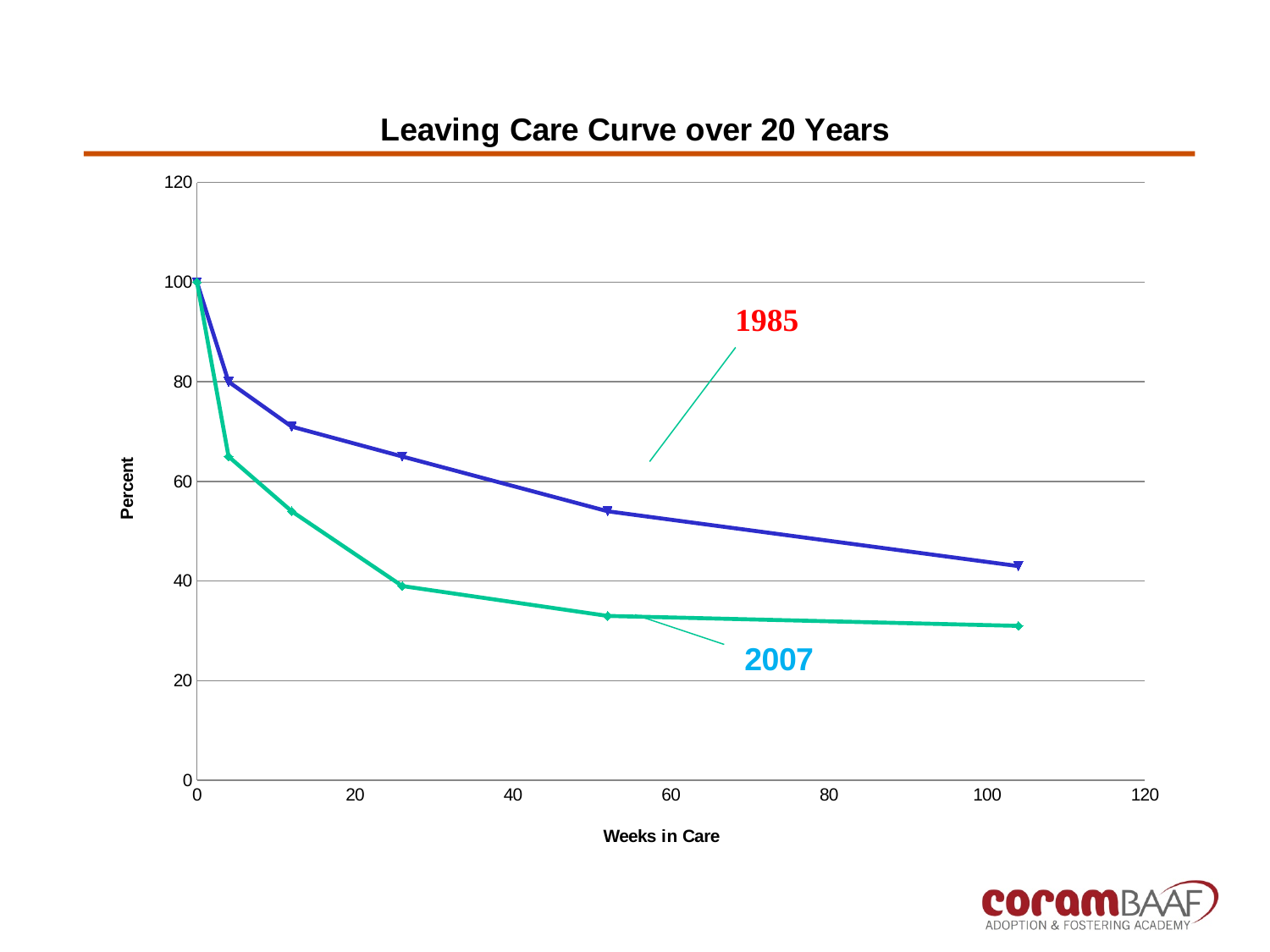
What is the label of the x axis? Weeks in Care At around 52 weeks in care, which series has the higher value, 1985 or 2007? 1985 How many data points are plotted for the 1985 series? 6 Do the values of the 2007 series rise or fall as weeks in care increase? fall Is the value for the 2007 series at around 52 weeks greater or less than 40? less What kind of chart is shown on the slide? line chart How many series are plotted on the chart? 2 Is the value for the 1985 series at around 104 weeks greater or less than 60? less Is the value for the 1985 series at around 26 weeks greater or less than 60? greater What is the title of the chart? Leaving Care Curve over 20 Years What is the value of both series at 0 weeks in care? 100